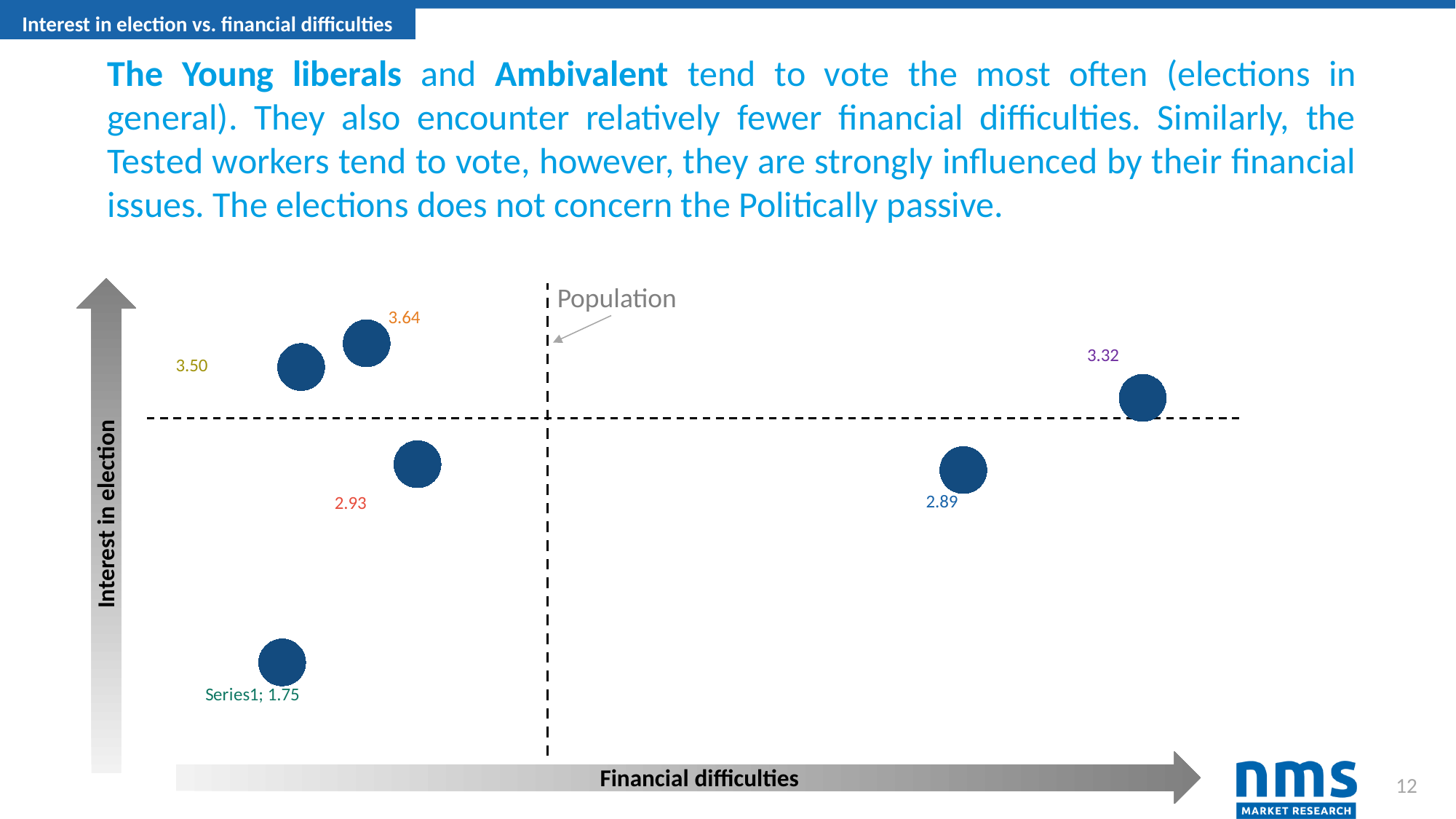
How many data points are plotted on the chart? 6 Which is larger, the data label 3.32 or the data label 2.89? 3.32 What is the difference between the data labels 3.64 and 3.50? 0.14 What is the lowest data label value shown on the chart? 1.75 What do the dashed lines on the chart represent? Population What is the highest data label value shown on the chart? 3.64 What is the difference between the data labels 2.93 and 2.89? 0.04 What is the difference between the highest data label (3.64) and the lowest data label (1.75)? 1.89 How many data points lie above the horizontal dashed Population line? 3 What is the label of the horizontal axis of the chart? Financial difficulties How many data points lie to the right of the vertical dashed Population line? 2 What kind of chart is shown on the slide? Scatter chart